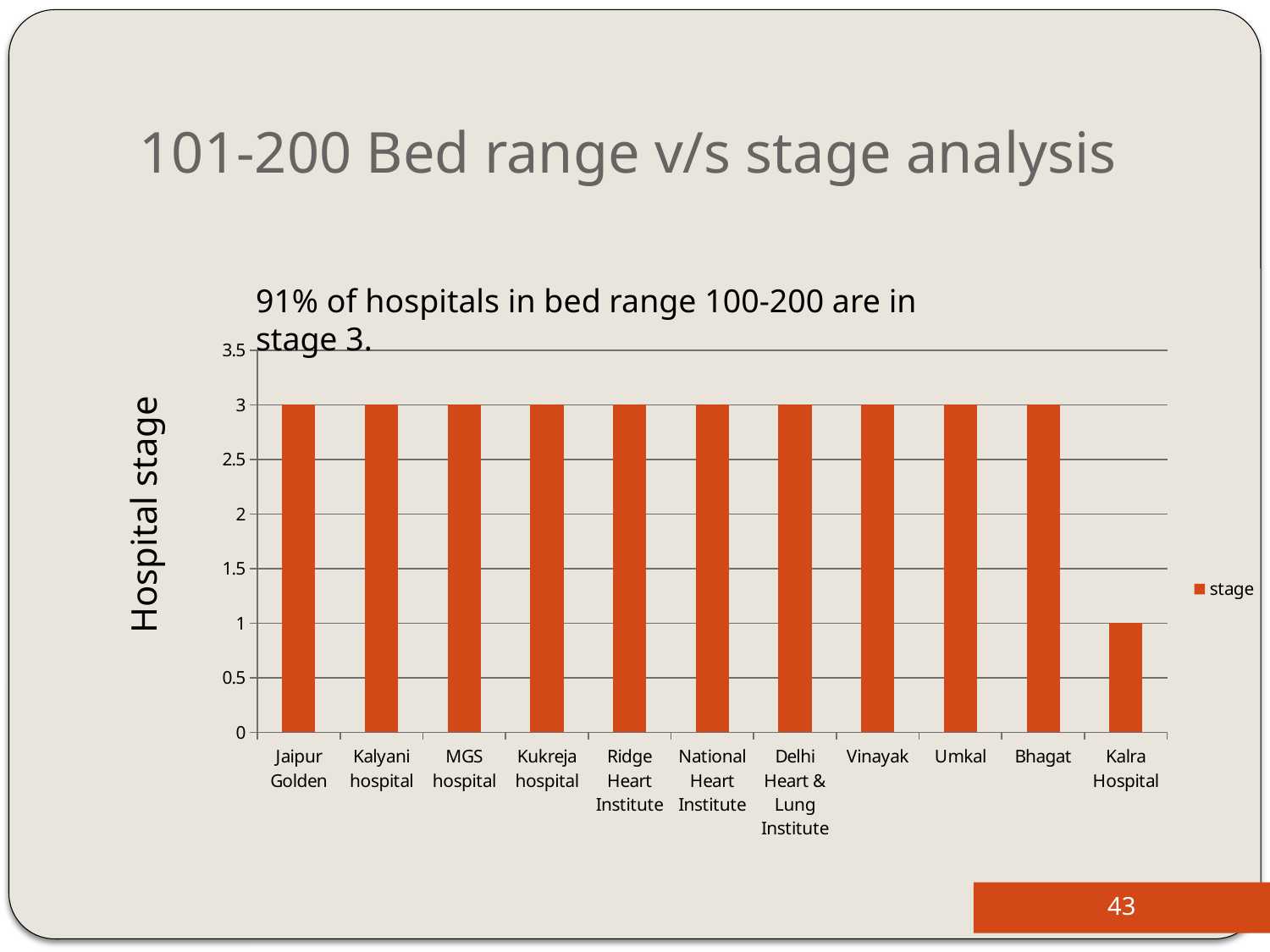
What kind of chart is shown on the slide? bar chart What is the stage value for Jaipur Golden? 3 What is the difference between the stage value for Bhagat and the stage value for Kalra Hospital? 2 What is the stage value for Delhi Heart & Lung Institute? 3 What is the name of the series shown in the chart legend? stage What is the label on the y axis of the chart? Hospital stage Which hospital has the lowest stage value? Kalra Hospital How many series does the chart legend list? 1 What is the stage value for Kalra Hospital? 1 Is the stage value for Vinayak greater or less than 2? greater How many hospitals are shown on the x axis of the chart? 11 Which has a larger stage value, Umkal or Kalra Hospital? Umkal